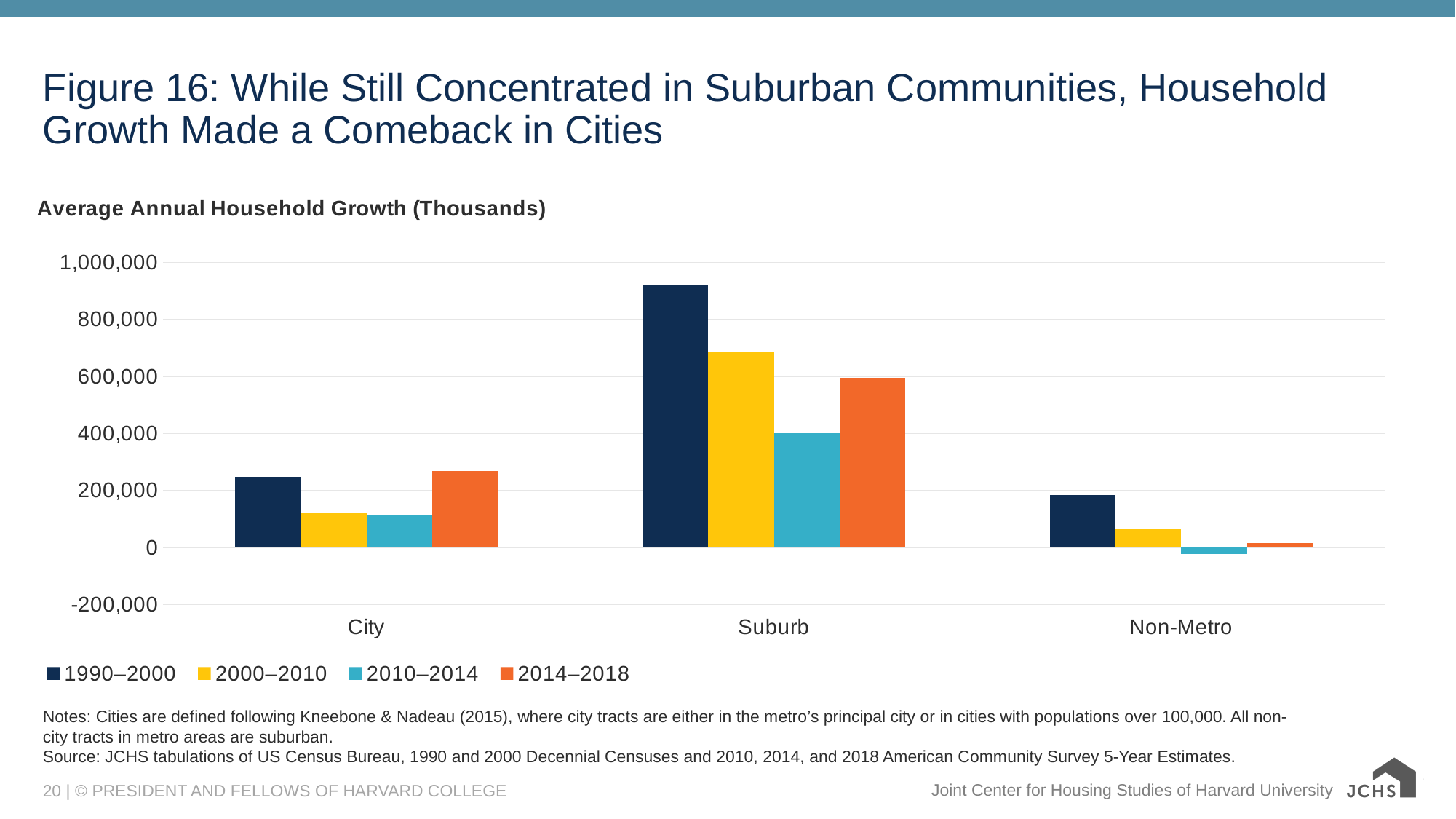
Is the value for Non-Metro in 2010–2014 greater or less than 0? less Which series is shown in orange in the legend? 2014–2018 For the City category, which is larger: the 1990–2000 value or the 2000–2010 value? 1990–2000 How many categories are shown on the x axis? 3 For the Suburb category, which is larger: the 2000–2010 value or the 2014–2018 value? 2000–2010 Is the value for Suburb in 1990–2000 greater or less than 800,000? greater How many series does the legend list? 4 Which category has the lowest value for the 2010–2014 series? Non-Metro Which category has the highest value for the 1990–2000 series? Suburb What kind of chart is shown on the slide? bar chart Is the value for City in 2014–2018 greater or less than 200,000? greater